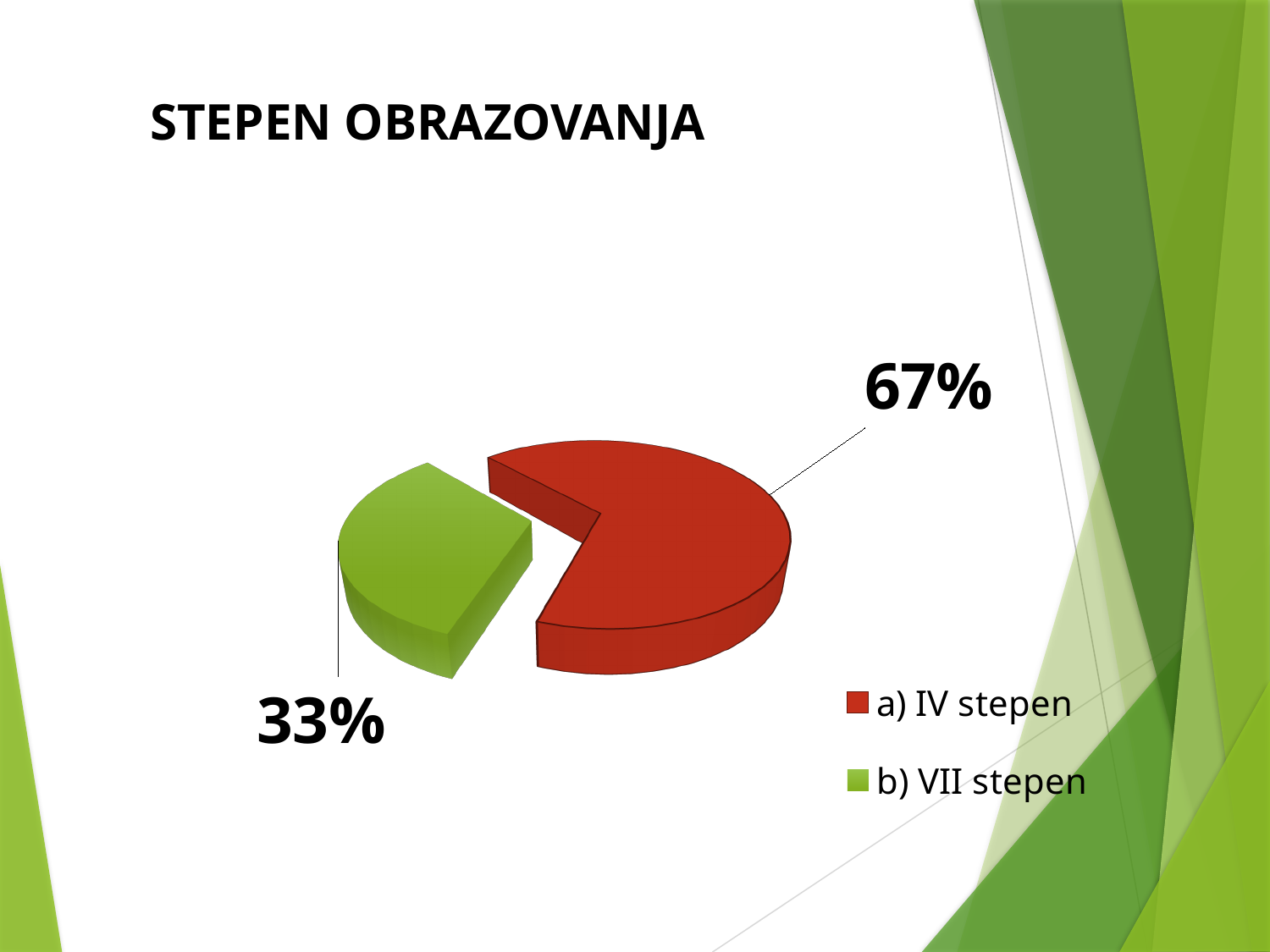
Which category has the smallest share of the pie? b) VII stepen What percentage is shown for a) IV stepen? 67% What kind of chart is shown on the slide? pie chart What is the title of the slide? STEPEN OBRAZOVANJA What colour is the slice for b) VII stepen? green How many slices does the pie chart have? 2 How many entries does the legend list? 2 Which category has the largest share of the pie? a) IV stepen What is the difference in percentage points between a) IV stepen and b) VII stepen? 34 Which is larger, the share for a) IV stepen or for b) VII stepen? a) IV stepen What percentage is shown for b) VII stepen? 33%